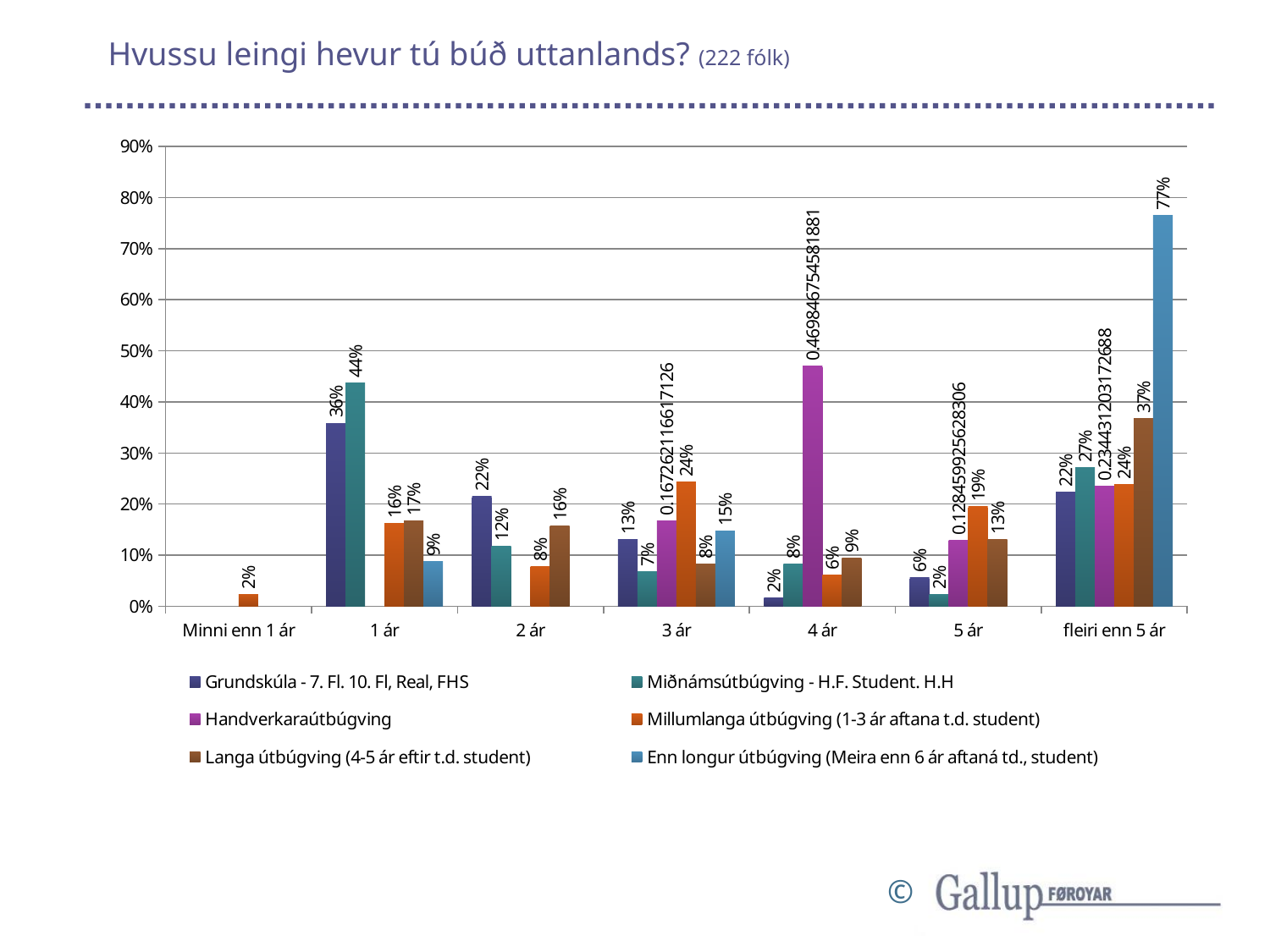
Is the value for Handverkaraútbúgving in the '4 ár' category greater or less than 40%? greater In which category is the value for Langa útbúgving highest? fleiri enn 5 ár What kind of chart is shown on the slide? bar chart What is the data label shown for Handverkaraútbúgving in the '4 ár' category? 0.469846754581881 What is the value for Enn longur útbúgving in the 'fleiri enn 5 ár' category? 77% How many series does the legend list? 6 How many categories are shown on the x axis? 7 What is the difference between the Grundskúla values for '1 ár' and '2 ár'? 14 percentage points What is the value for Millumlanga útbúgving in the 'Minni enn 1 ár' category? 2% What is the value for Langa útbúgving in the '5 ár' category? 13% In the '3 ár' category, which is larger: Millumlanga útbúgving or Grundskúla? Millumlanga útbúgving What is the value for Miðnámsútbúgving in the '1 ár' category? 44%